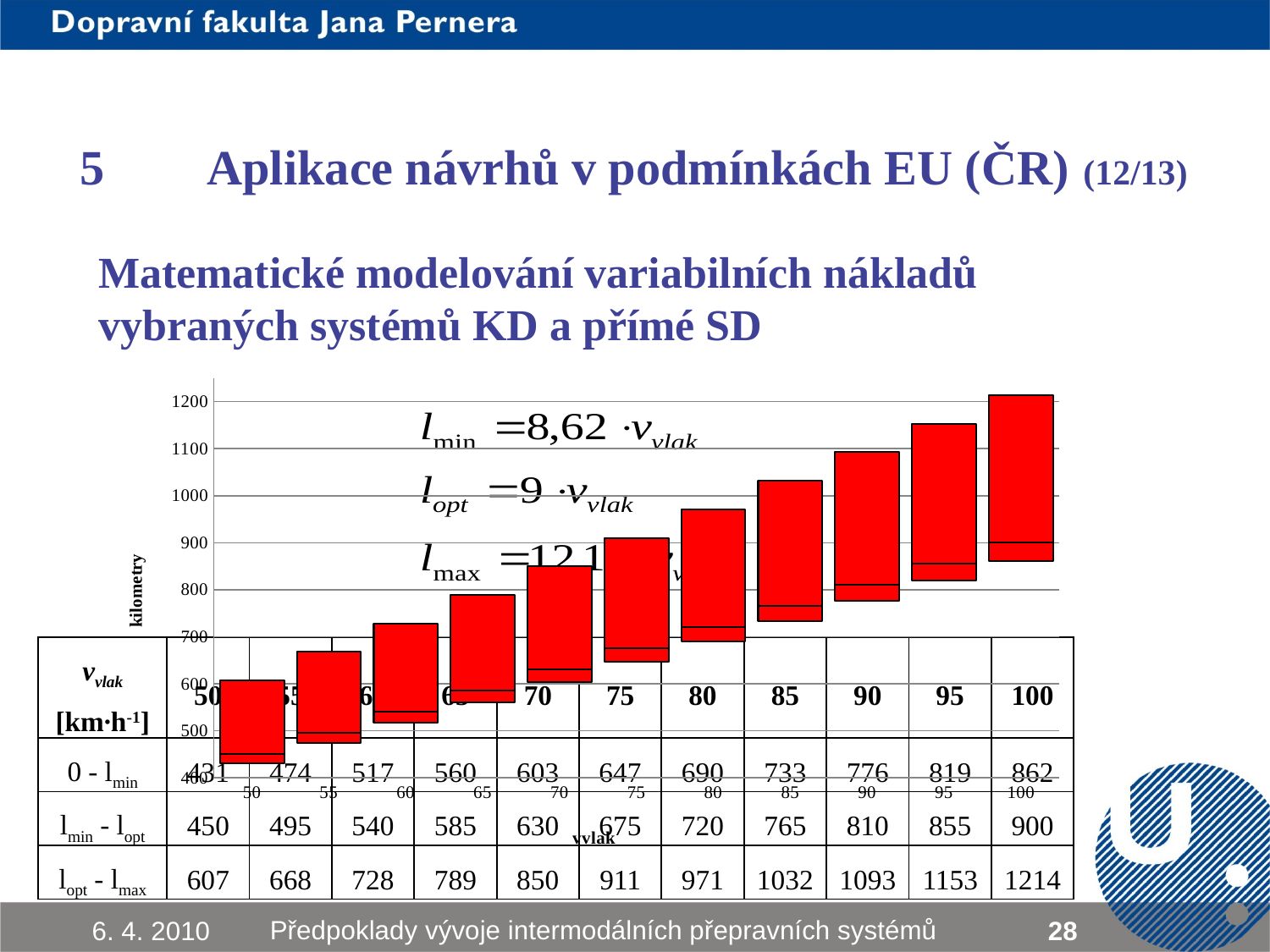
According to the table under the chart, what is the l_min - l_opt value for v_vlak = 80 km·h⁻¹? 720 Is the top of the bar for v_vlak = 60 greater or less than 800 kilometres? less How many v_vlak categories are plotted along the x axis of the chart? 11 Do the bars rise or fall as v_vlak increases along the x axis? rise For which v_vlak value does the bar reach the lowest point on the chart? 50 According to the table under the chart, what is the l_opt - l_max value for v_vlak = 100 km·h⁻¹? 1214 According to the table under the chart, what is the 0 - l_min value for v_vlak = 70 km·h⁻¹? 603 What is the difference between the l_opt - l_max values for v_vlak = 100 and v_vlak = 50? 607 What kind of chart is shown on the slide? bar chart What is the difference between the l_min - l_opt values for v_vlak = 100 and v_vlak = 50? 450 For which v_vlak value does the bar reach the highest point on the chart? 100 Which bar reaches higher on the chart, the one for v_vlak = 95 or the one for v_vlak = 90? 95